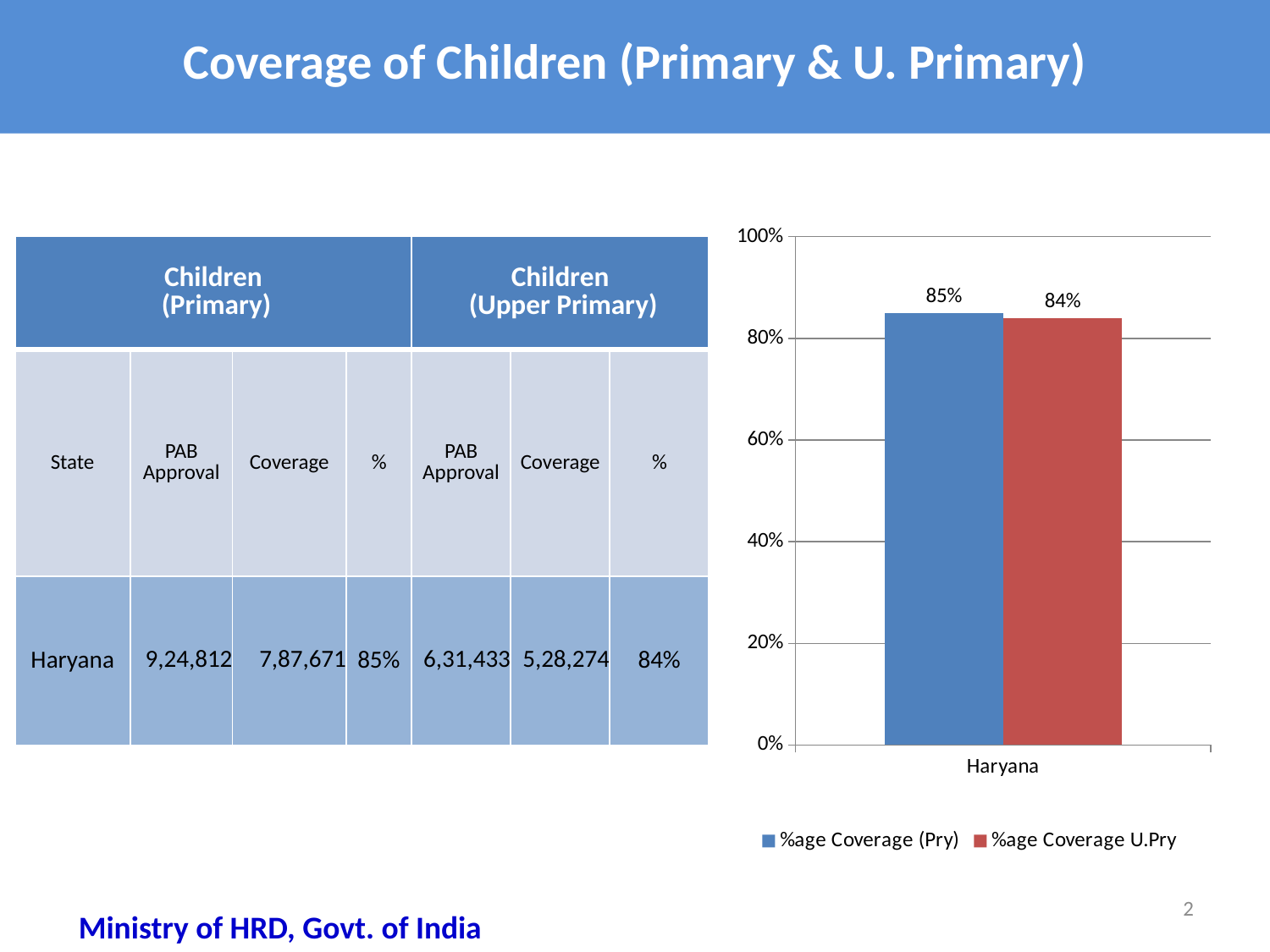
Is the value for %age Coverage (Pry) for Haryana greater or less than 100%? less What kind of chart is shown on the slide? Bar chart What is the highest value shown on the chart's y axis? 100% How many categories are shown on the x axis of the chart? 1 How many series does the chart legend list? 2 Which series has the higher value for Haryana in the chart, %age Coverage (Pry) or %age Coverage U.Pry? %age Coverage (Pry) Is the value for %age Coverage U.Pry for Haryana greater or less than 80%? greater Which category is shown on the x axis of the chart? Haryana What is the value of %age Coverage U.Pry for Haryana in the chart? 84% What is the value of %age Coverage (Pry) for Haryana in the chart? 85% What is the difference between the %age Coverage (Pry) and %age Coverage U.Pry values for Haryana in the chart? 1% What colour is the %age Coverage U.Pry bar in the chart? Red